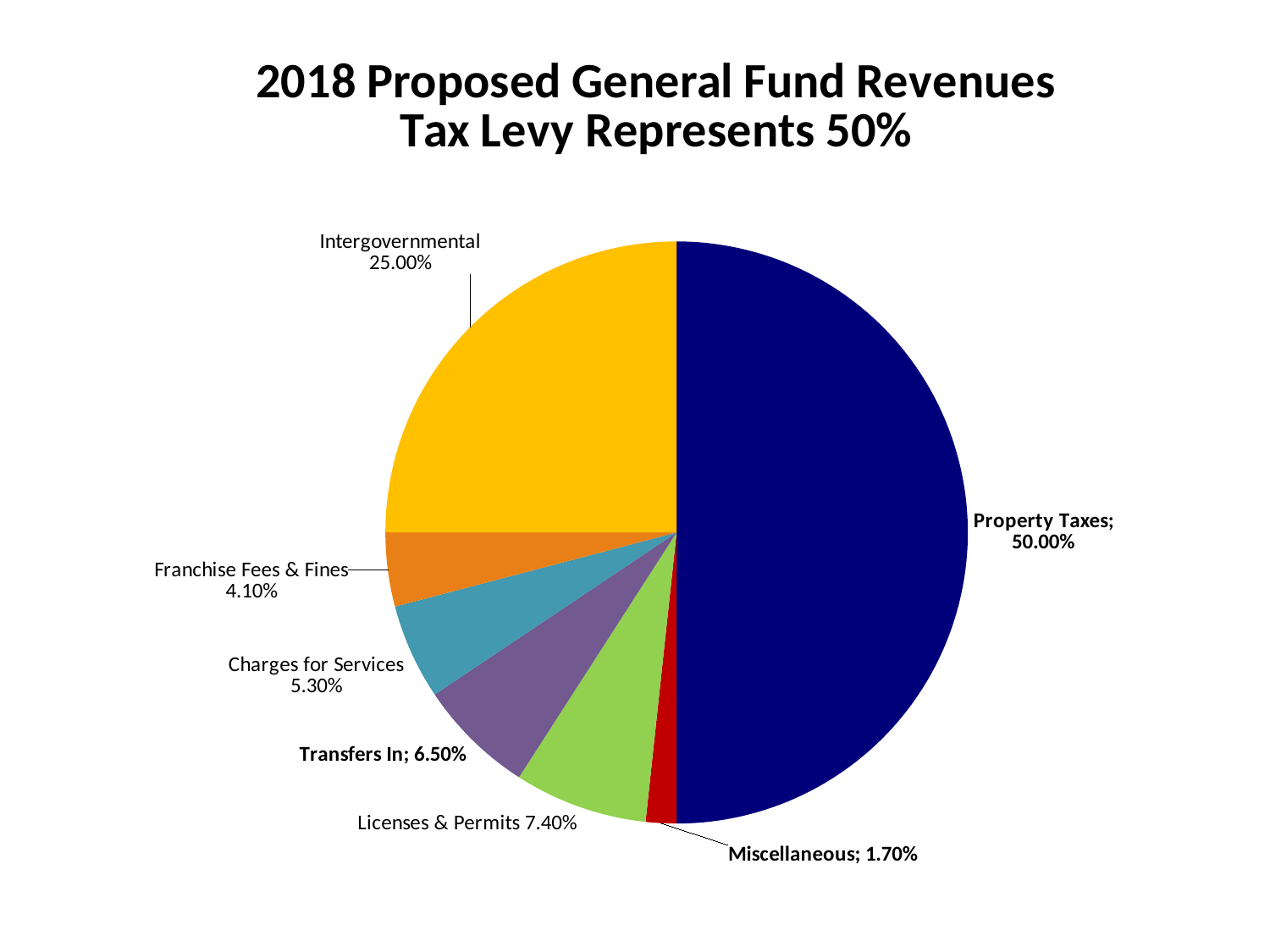
Which category has the largest slice of the pie? Property Taxes How many categories are shown in the pie chart? 7 What share of the pie does Property Taxes represent? 50.00% What is the value shown for Licenses & Permits? 7.40% What is the value shown for Intergovernmental? 25.00% What is the value shown for Charges for Services? 5.30% What is the title of the chart? 2018 Proposed General Fund Revenues Tax Levy Represents 50% What is the difference between the Property Taxes share and the Intergovernmental share? 25.00% Which category has the smallest slice of the pie? Miscellaneous What is the value shown for Transfers In? 6.50% Which is larger, Charges for Services or Franchise Fees & Fines? Charges for Services What kind of chart is shown on the slide? Pie chart